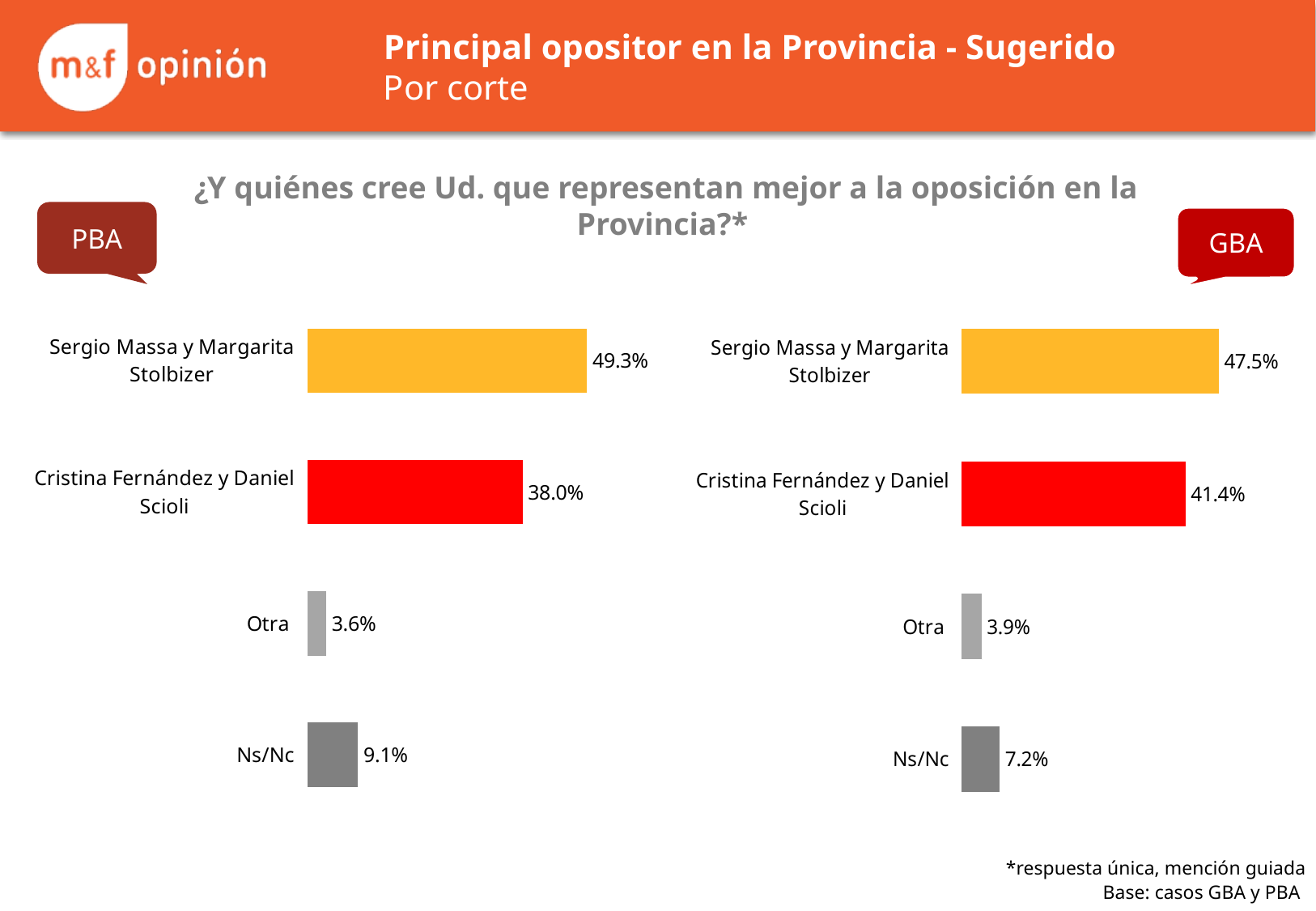
What colour is the bar for Cristina Fernández y Daniel Scioli in the PBA chart? Red In the PBA chart, what is the value for Ns/Nc? 9.1% What type of chart is the GBA chart? Bar chart In the GBA chart, what is the value for Cristina Fernández y Daniel Scioli? 41.4% Which is larger: the value for Cristina Fernández y Daniel Scioli in the PBA chart or in the GBA chart? GBA In the PBA chart, what is the difference between Sergio Massa y Margarita Stolbizer and Cristina Fernández y Daniel Scioli? 11.3% In the PBA chart, which category has the lowest value? Otra How many categories does the PBA chart show? 4 In the GBA chart, which category has the highest value? Sergio Massa y Margarita Stolbizer In the PBA chart, what is the value for Sergio Massa y Margarita Stolbizer? 49.3% In the GBA chart, what is the difference between Ns/Nc and Otra? 3.3% In the GBA chart, what is the value for Otra? 3.9%